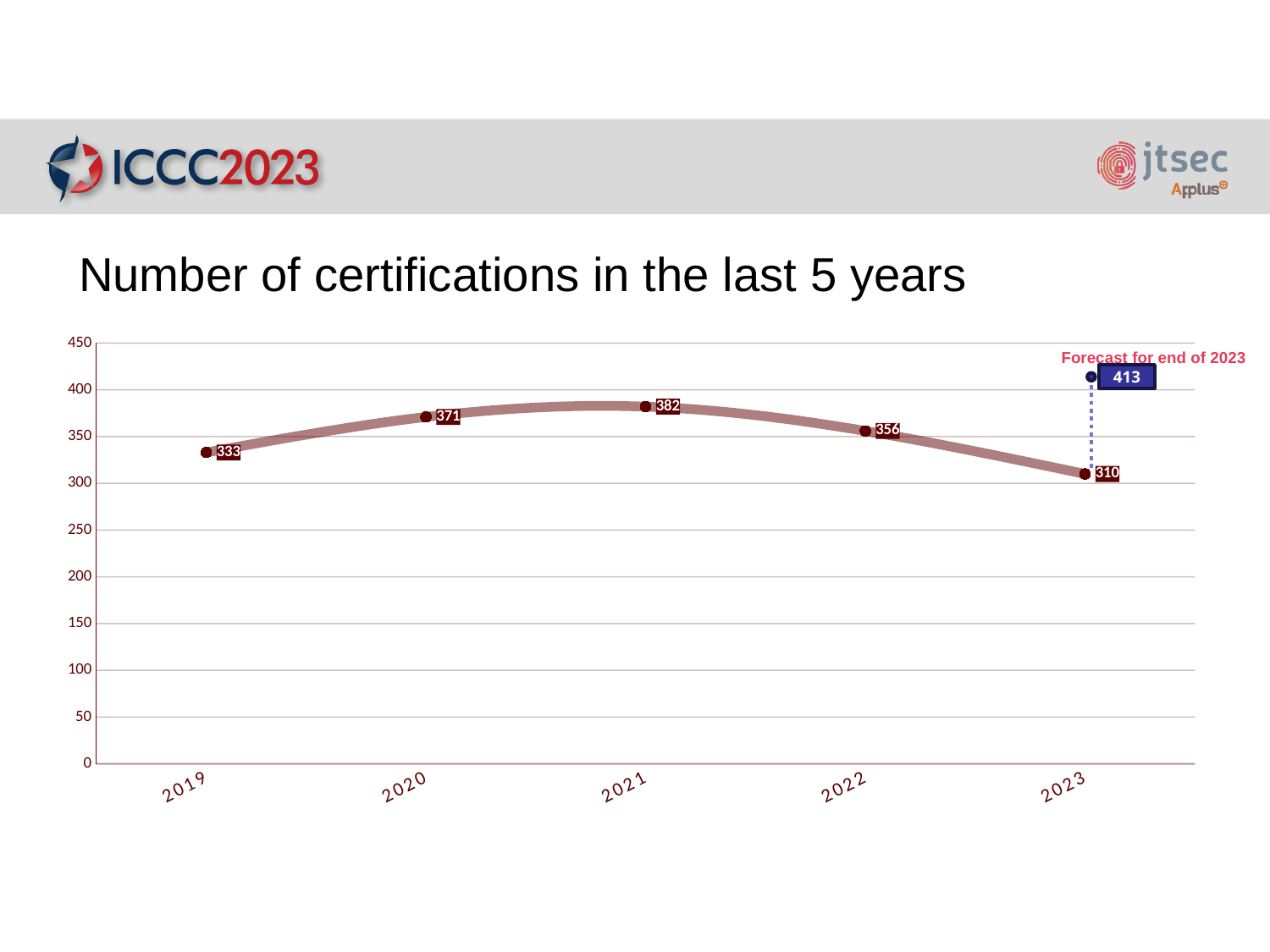
What is the number of certifications in 2021? 382 What is the difference between the forecast for end of 2023 and the plotted 2023 value? 103 How many years are shown on the x axis? 5 Which year has the lowest number of certifications among the plotted actual values? 2023 Which year has the highest number of certifications among the plotted actual values? 2021 What is the forecast value for the end of 2023? 413 What is the number of certifications shown for 2023? 310 Which year has more certifications, 2020 or 2022? 2020 What is the title of the chart? Number of certifications in the last 5 years What kind of chart is this? Line chart What is the number of certifications in 2019? 333 What is the difference between the certifications in 2021 and 2022? 26